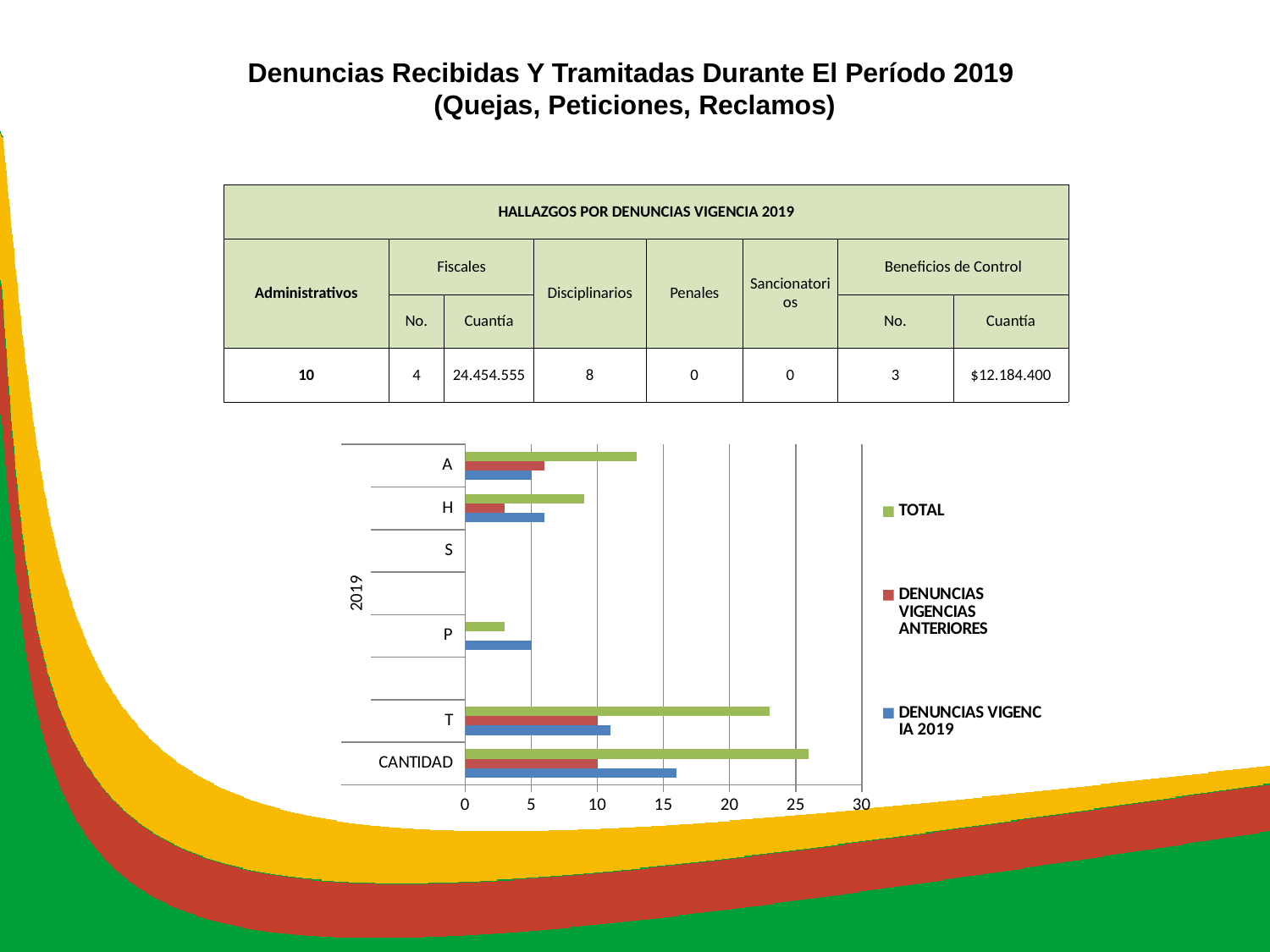
Which category has the highest TOTAL value? CANTIDAD How many series does the chart legend list? 3 Is the TOTAL value for CANTIDAD greater or less than 20? greater Is the TOTAL value for P greater or less than 5? less Is the DENUNCIAS VIGENCIA 2019 value for CANTIDAD greater or less than 10? greater What colour represents the TOTAL series in the chart? green Which has a larger TOTAL value, A or H? A For CANTIDAD, which is larger: DENUNCIAS VIGENCIA 2019 or DENUNCIAS VIGENCIAS ANTERIORES? DENUNCIAS VIGENCIA 2019 What kind of chart is shown on the slide? bar chart What is the highest value shown on the chart's horizontal axis? 30